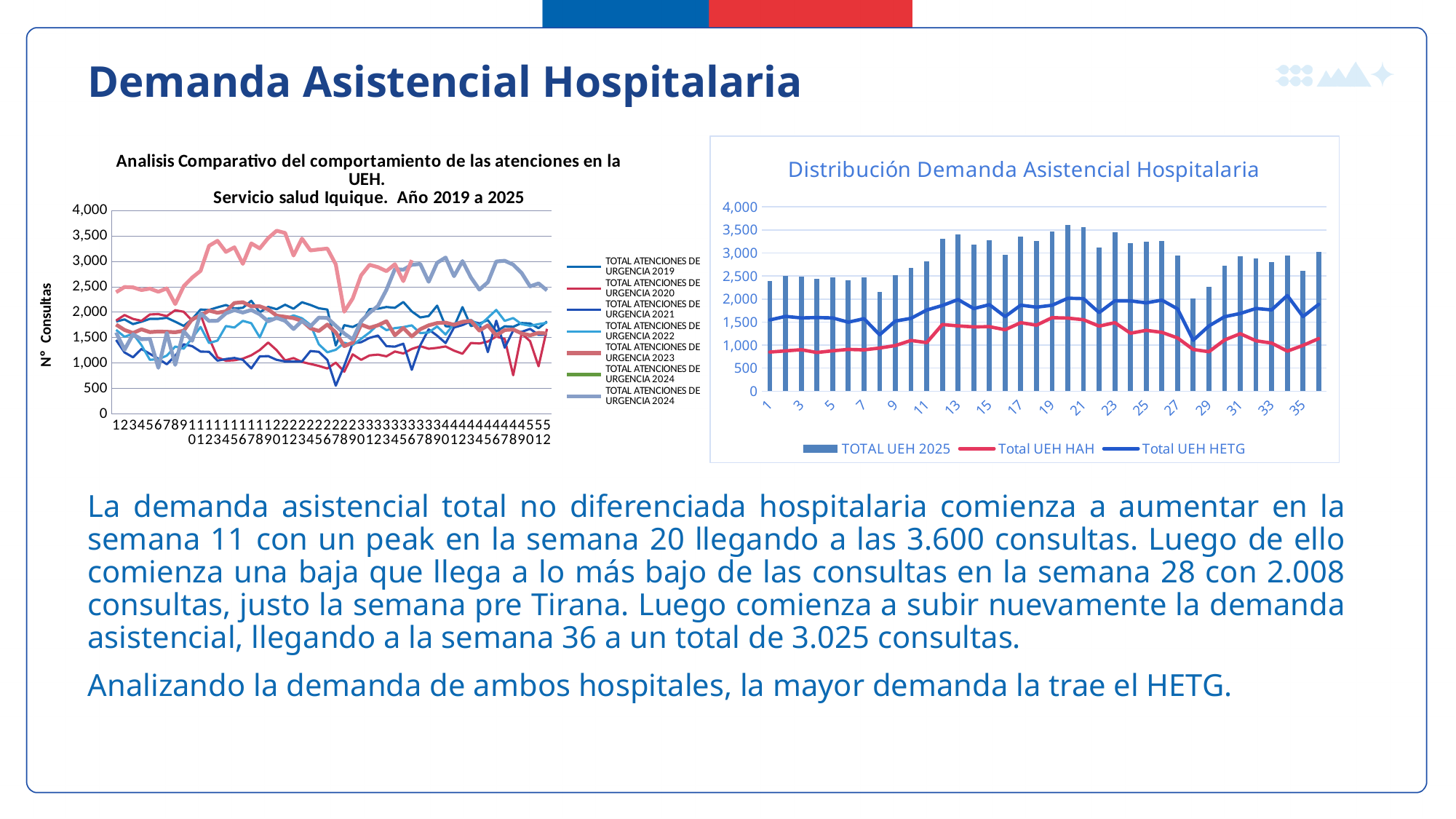
What type of chart is the 'Distribución Demanda Asistencial Hospitalaria' chart on the right? Combined bar and line chart What type of chart is the 'Analisis Comparativo' chart on the left? Line chart What is the y-axis label of the 'Analisis Comparativo' chart on the left? N° Consultas In the 'Distribución Demanda Asistencial Hospitalaria' chart, which week has the lowest TOTAL UEH 2025 bar? 28 In the 'Distribución Demanda Asistencial Hospitalaria' chart, is the TOTAL UEH 2025 value for week 28 greater or less than 2,500? less In the 'Distribución Demanda Asistencial Hospitalaria' chart, how many series does the legend list? 3 In the 'Distribución Demanda Asistencial Hospitalaria' chart, is the TOTAL UEH 2025 value for week 1 greater or less than 2,000? greater In the 'Distribución Demanda Asistencial Hospitalaria' chart, is the TOTAL UEH 2025 value for week 20 greater or less than 3,000? greater In the 'Analisis Comparativo' chart on the left, how many entries does the legend list? 7 In the 'Distribución Demanda Asistencial Hospitalaria' chart, which series is higher at week 20, Total UEH HAH or Total UEH HETG? Total UEH HETG In the 'Distribución Demanda Asistencial Hospitalaria' chart, which week has the highest TOTAL UEH 2025 bar? 20